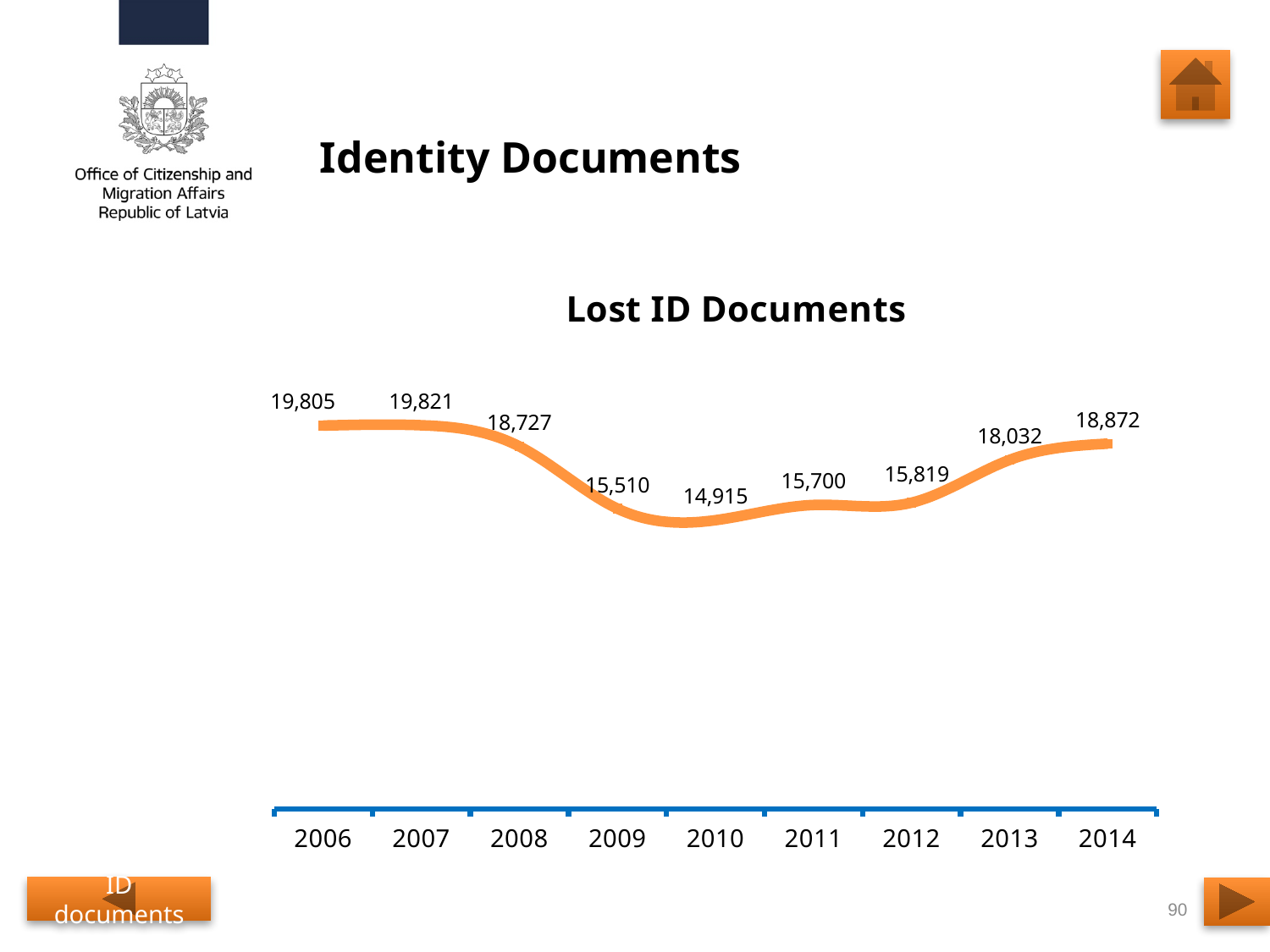
Which is larger in the Lost ID Documents chart, the value for 2011 or the value for 2012? 2012 How many years are plotted in the Lost ID Documents chart? 9 What is the difference between the values for 2014 and 2013 in the Lost ID Documents chart? 840 What is the title of the chart on the slide? Lost ID Documents Which year has the lowest value in the Lost ID Documents chart? 2010 Do the values in the Lost ID Documents chart rise or fall from 2010 to 2014? rise What is the value for 2010 in the Lost ID Documents chart? 14,915 What is the value for 2006 in the Lost ID Documents chart? 19,805 What is the value for 2014 in the Lost ID Documents chart? 18,872 Which year has the highest value in the Lost ID Documents chart? 2007 What kind of chart is the Lost ID Documents chart? line chart What is the difference between the values for 2008 and 2009 in the Lost ID Documents chart? 3,217